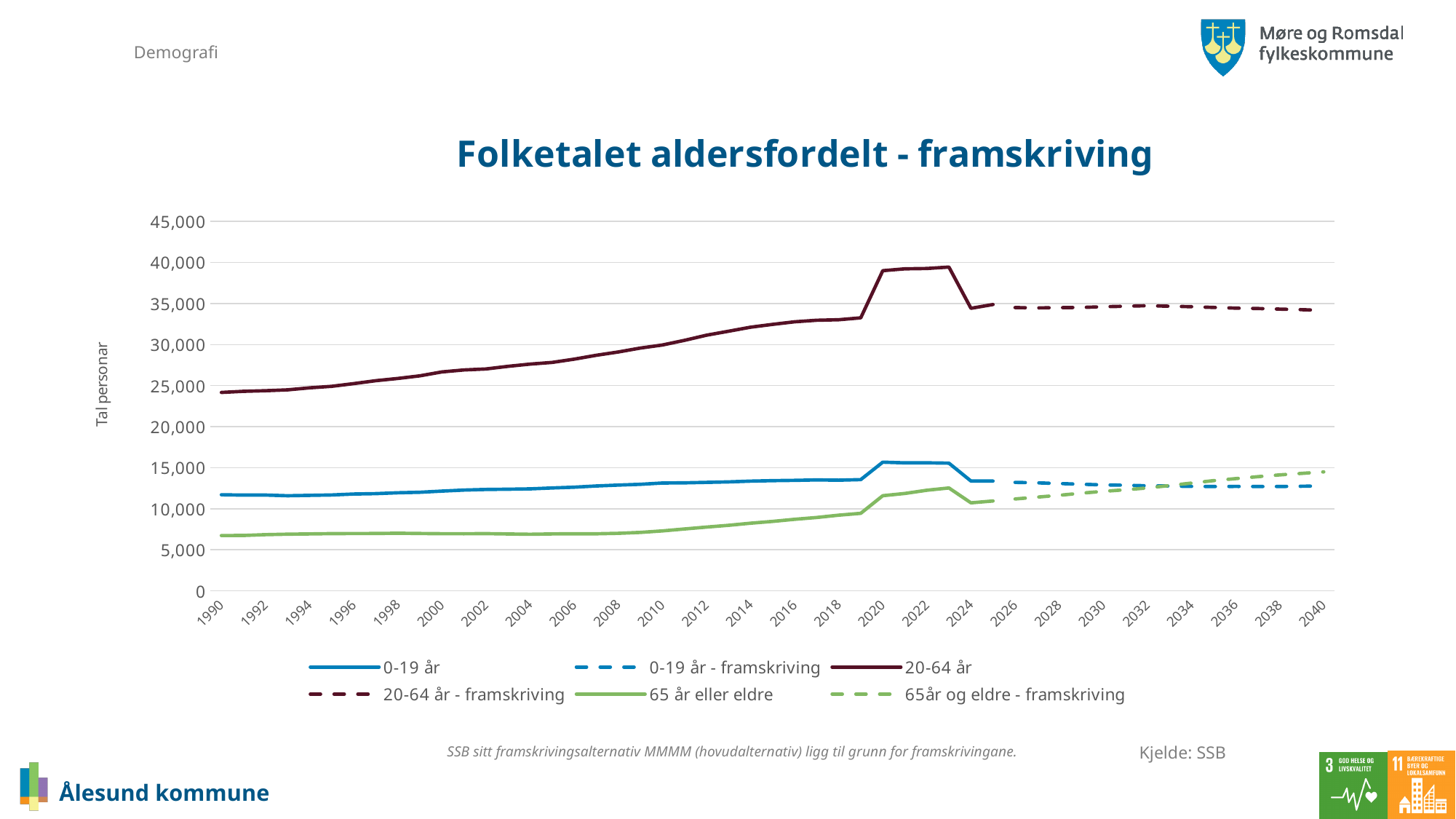
Is the value for 0-19 år in 2010 greater or less than 15,000? less Is the value for 20-64 år in 1990 greater or less than 20,000? greater What kind of chart is shown on the slide? line chart How many series does the legend list? 6 Which age group has the highest values across the whole period? 20-64 år Does the 65 år eller eldre line rise or fall from 1990 to 2022? rise How many year labels are shown on the x axis? 26 Is the value for 65 år eller eldre in 1990 greater or less than 10,000? less What is the label on the vertical axis? Tal personar In 2040, which is higher: 0-19 år - framskriving or 65år og eldre - framskriving? 65år og eldre - framskriving What is the title of the chart? Folketalet aldersfordelt - framskriving